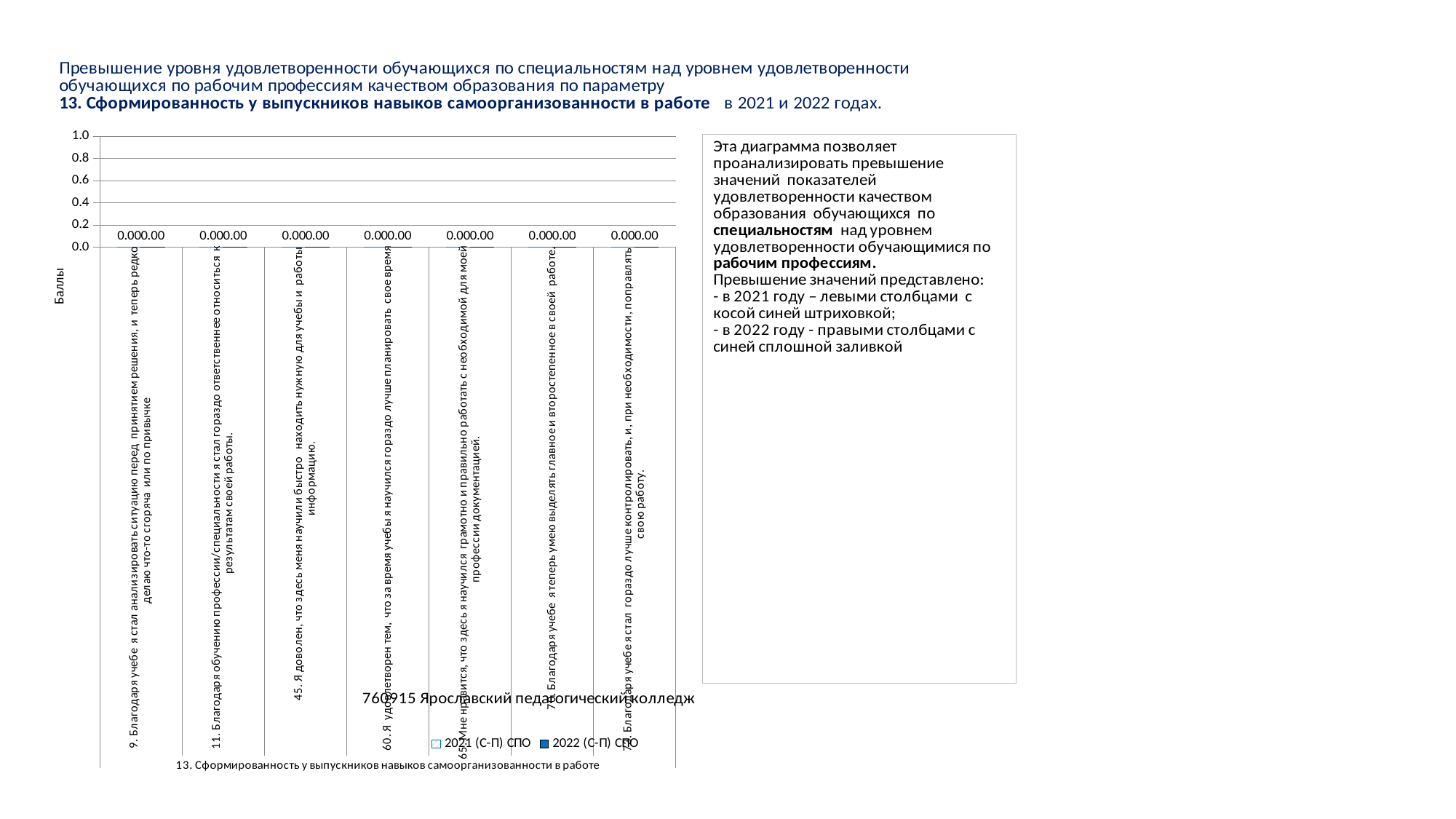
What kind of chart is shown on the slide? bar chart How many categories are shown along the x axis of the chart? 7 What are the two series named in the chart legend? 2021 (С-П) СПО and 2022 (С-П) СПО What is the label on the vertical axis of the chart? Баллы What value is printed as the data label above the category '65. Мне нравится, что здесь я научился грамотно и правильно работать с необходимой для моей профессии документацией.'? 0.00 What is the difference between the data label values for the categories '45. Я доволен...' and '60. Я удовлетворен тем...'? 0.00 How many series does the chart legend list? 2 What value is printed as the data label above the category '60. Я удовлетворен тем, что за время учебы я научился гораздо лучше планировать свое время'? 0.00 Is the value for the category '9. Благодаря учебе я стал анализировать ситуацию перед принятием решения...' greater or less than 0.2? less What is the highest tick value shown on the vertical axis of the chart? 1.0 What value is printed as the data label above the category '45. Я доволен, что здесь меня научили быстро находить нужную для учебы и работы информацию.'? 0.00 Is the value for the category '11. Благодаря обучению профессии/специальности я стал гораздо ответственнее относиться к результатам своей работы.' greater or less than 0.4? less